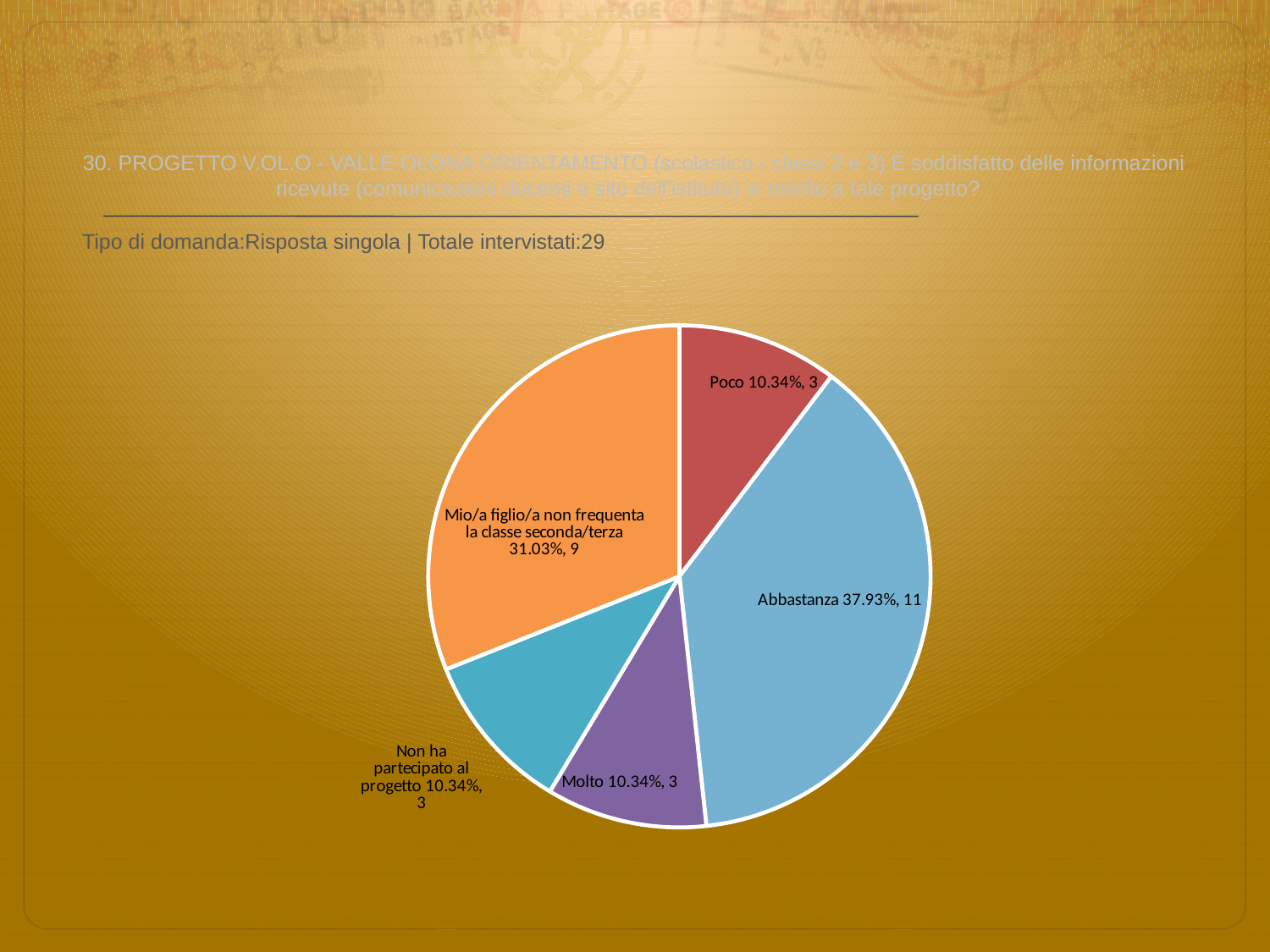
What is the count for the "Molto" slice? 3 What percentage share does the "Abbastanza" slice have? 37.93% What percentage share does the "Mio/a figlio/a non frequenta la classe seconda/terza" slice have? 31.03% What kind of chart is shown on the slide? pie chart How many slices does the pie chart have? 5 What is the total number of respondents (Totale intervistati) stated on the slide? 29 What is the count for the "Non ha partecipato al progetto" slice? 3 Which category has the largest slice of the pie? Abbastanza What is the count for the "Abbastanza" slice? 11 Which is larger, the "Abbastanza" slice or the "Poco" slice? Abbastanza What percentage share does the "Poco" slice have? 10.34% What is the difference in count between "Abbastanza" and "Mio/a figlio/a non frequenta la classe seconda/terza"? 2